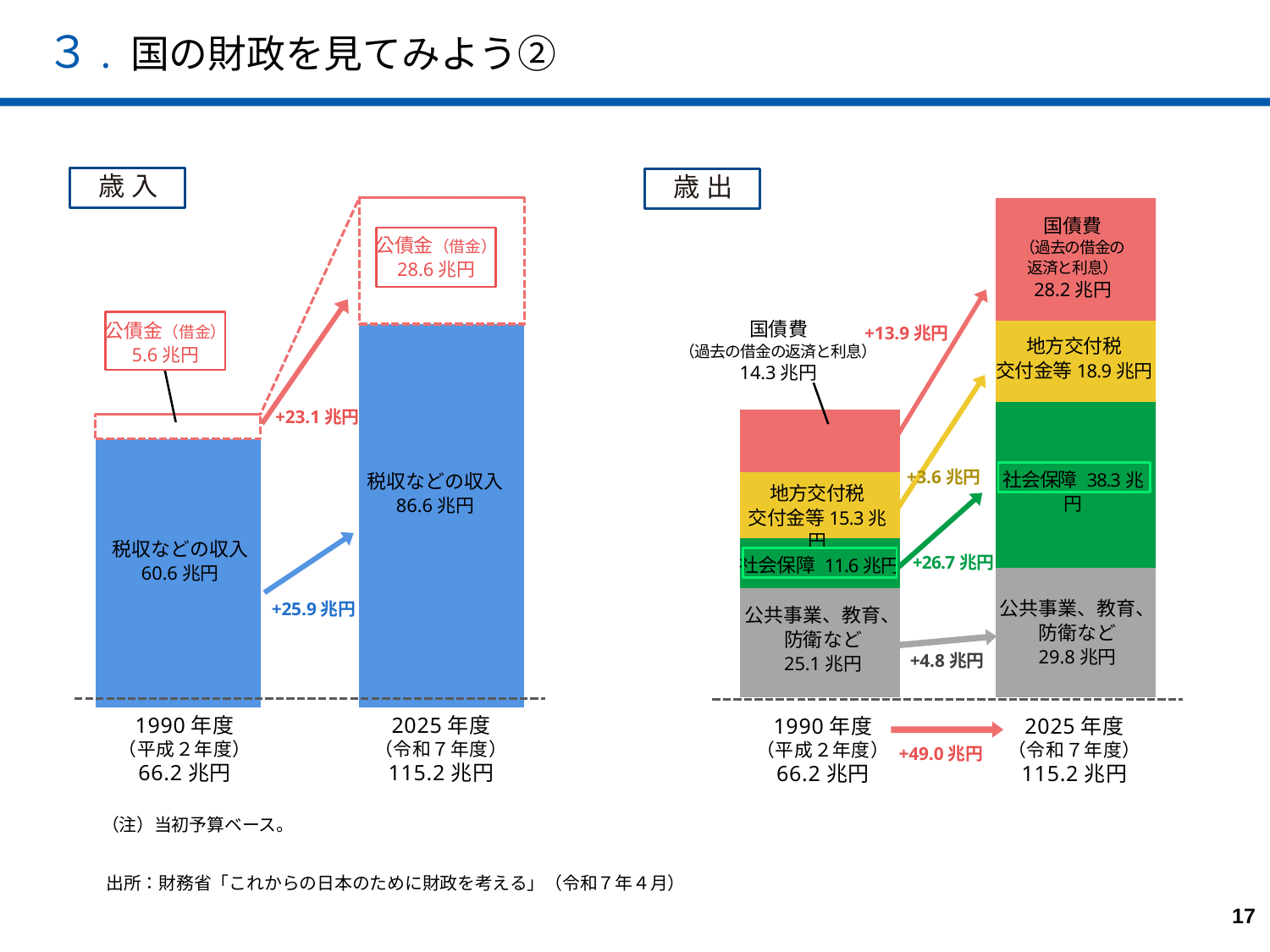
In the 歳入 chart, by how much did 公債金（借金） increase from 1990年度 to 2025年度? +23.1 兆円 In the 歳出 chart, which category is the smallest in 1990年度? 社会保障 In the 歳出 chart, what is the value of 国債費 for 1990年度? 14.3 兆円 In the 歳入 chart, what is the total for 2025年度? 115.2 兆円 In the 歳入 chart, what is the value of 税収などの収入 for 1990年度? 60.6 兆円 In the 歳出 chart, which category is the largest in 2025年度? 社会保障 In the 歳出 chart, how many categories make up each stacked bar? 4 What kind of chart is the 歳出 chart? Stacked bar chart In the 歳出 chart, what is the value of 社会保障 for 2025年度? 38.3 兆円 In the 歳入 chart, what is the value of 公債金（借金） for 2025年度? 28.6 兆円 In the 歳出 chart, which is larger in 2025年度: 国債費 or 地方交付税交付金等? 国債費 In the 歳出 chart, by how much did 社会保障 increase from 1990年度 to 2025年度? +26.7 兆円